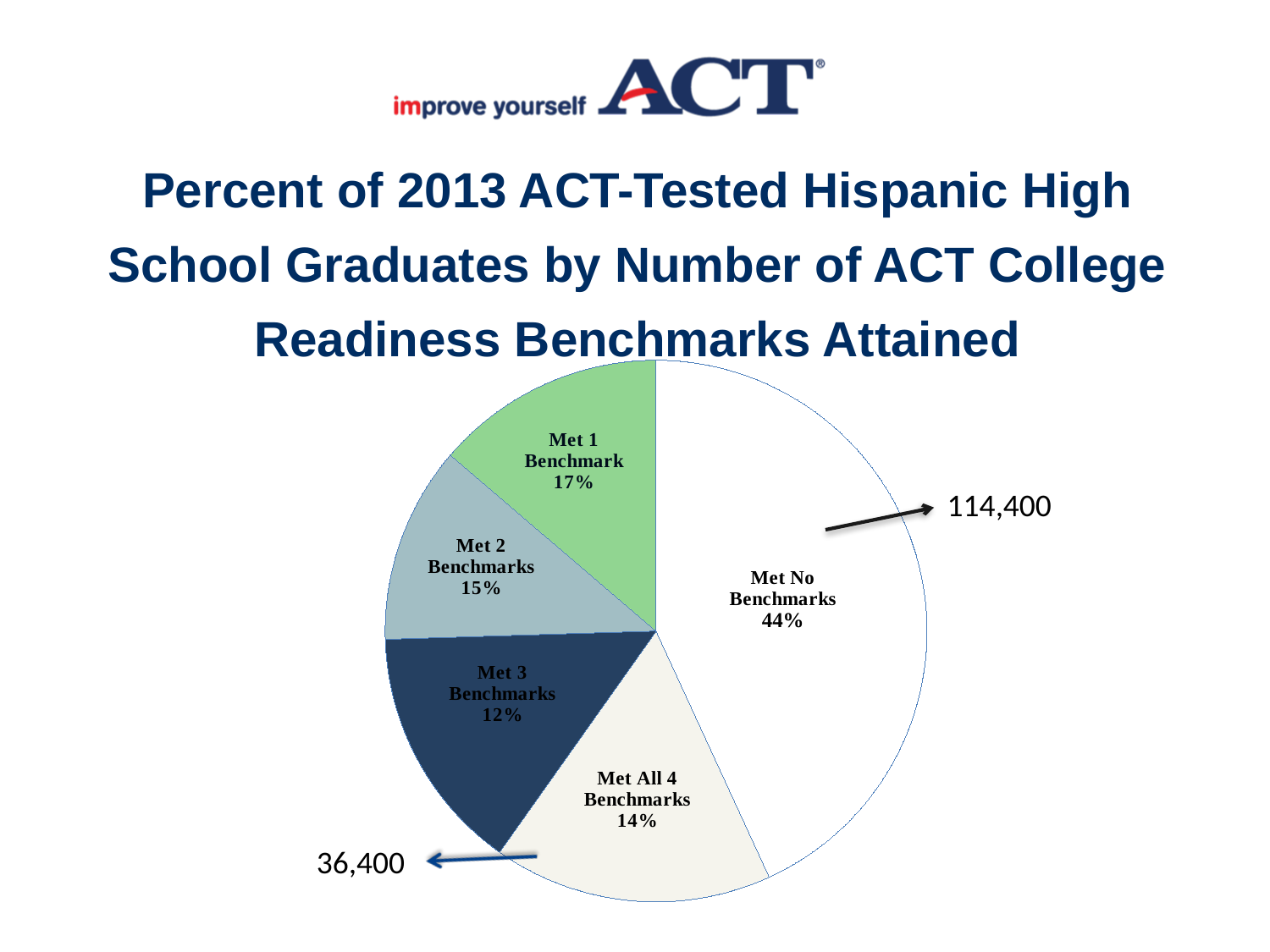
What number is annotated with an arrow pointing to the Met No Benchmarks slice? 114,400 What percentage of graduates met 2 benchmarks? 15% What kind of chart is shown on the slide? Pie chart What percentage of graduates met 3 benchmarks? 12% Which category has the smallest share of the pie? Met 3 Benchmarks What percentage of 2013 ACT-tested Hispanic high school graduates met no benchmarks? 44% How many slices does the pie chart have? 5 What percentage of graduates met all 4 benchmarks? 14% Which category has the largest share of the pie? Met No Benchmarks Which is larger: the share for Met 1 Benchmark or Met 2 Benchmarks? Met 1 Benchmark What is the difference in percentage points between Met No Benchmarks and Met 1 Benchmark? 27